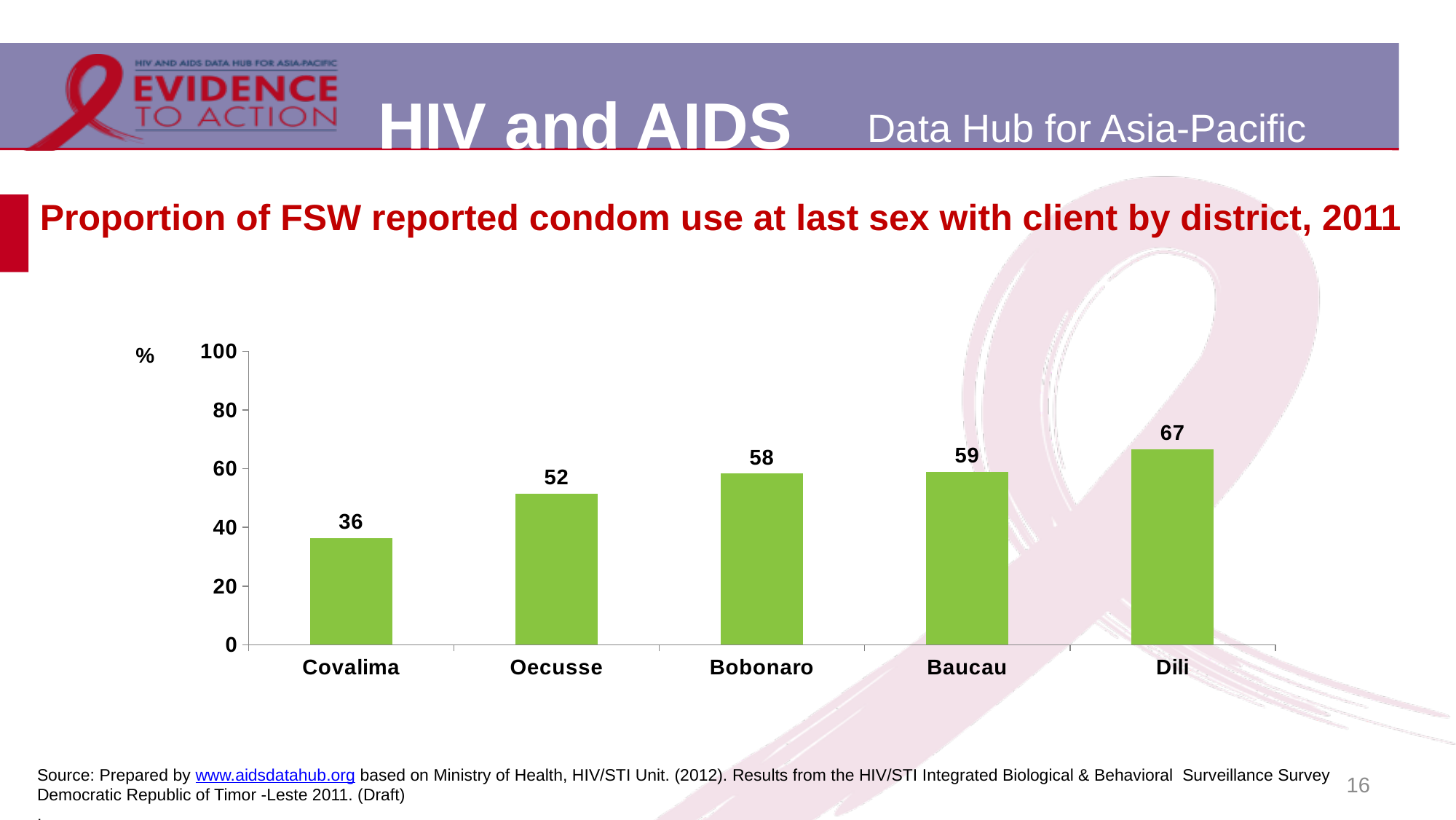
Which district has the highest proportion of FSW reporting condom use at last sex with client? Dili How many districts are shown in the chart? 5 What is the difference between the values for Oecusse and Covalima? 16 Which is larger, the value for Oecusse or the value for Dili? Dili What kind of chart is shown on the slide? bar chart What is the difference between the values for Dili and Covalima? 31 What is the value for Dili? 67 What is the value for Covalima? 36 What is the value for Bobonaro? 58 Is the value for Baucau greater or less than 40? greater Do the values rise or fall from Covalima to Dili along the x axis? rise Which district has the lowest proportion of FSW reporting condom use at last sex with client? Covalima